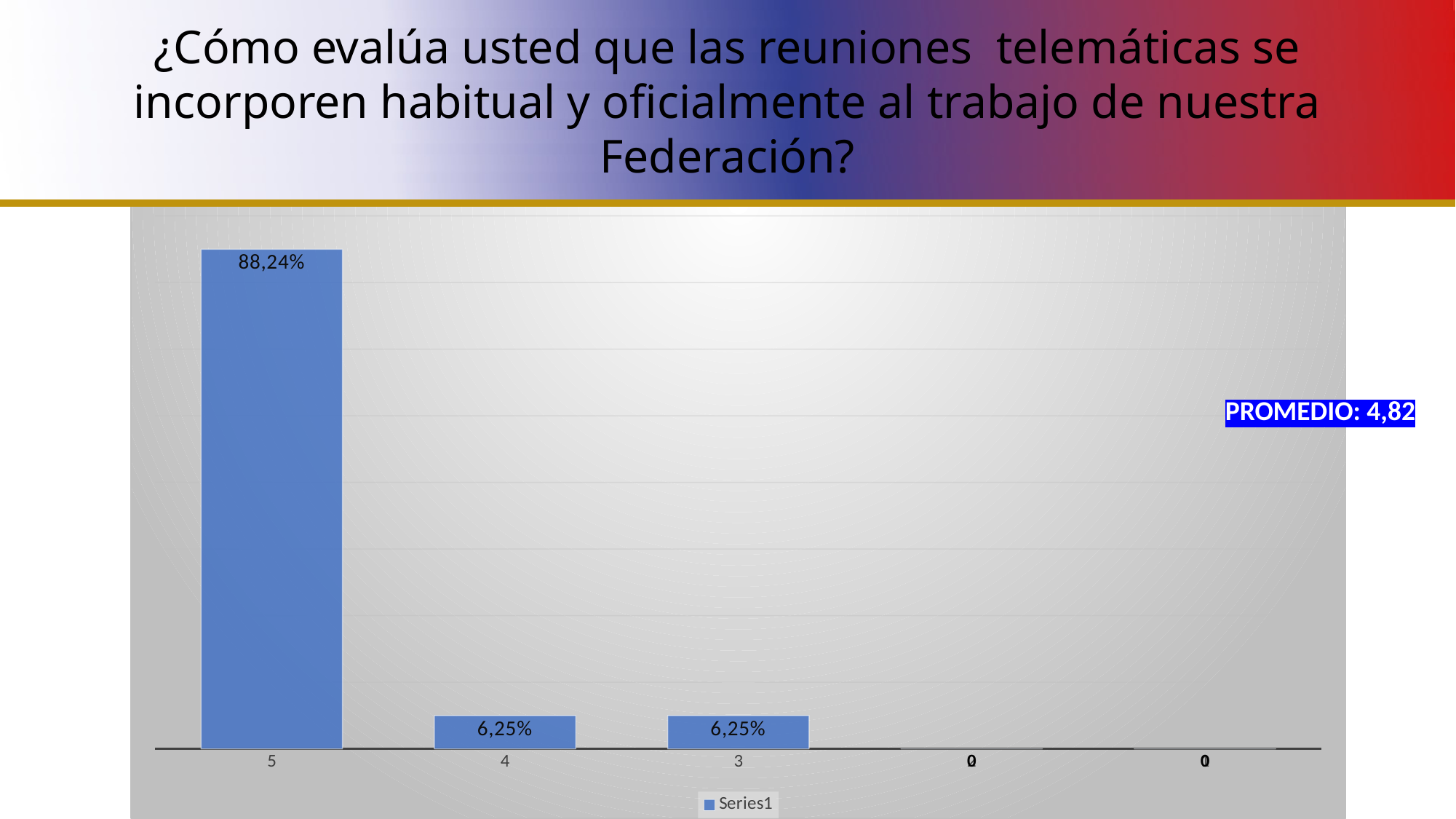
Which category has the highest value? 5 What PROMEDIO (average) value is shown in the box on the right of the chart? 4,82 How many series does the legend list? 1 What is the value for category 5? 88,24% How many categories are shown on the x axis? 5 What kind of chart is shown on the slide? bar chart Which is larger, the value for category 5 or the value for category 3? 5 What is the value for category 3? 6,25% What is the difference between the values for category 5 and category 4? 81,99% What is the name of the series shown in the legend? Series1 What is the value for category 4? 6,25%